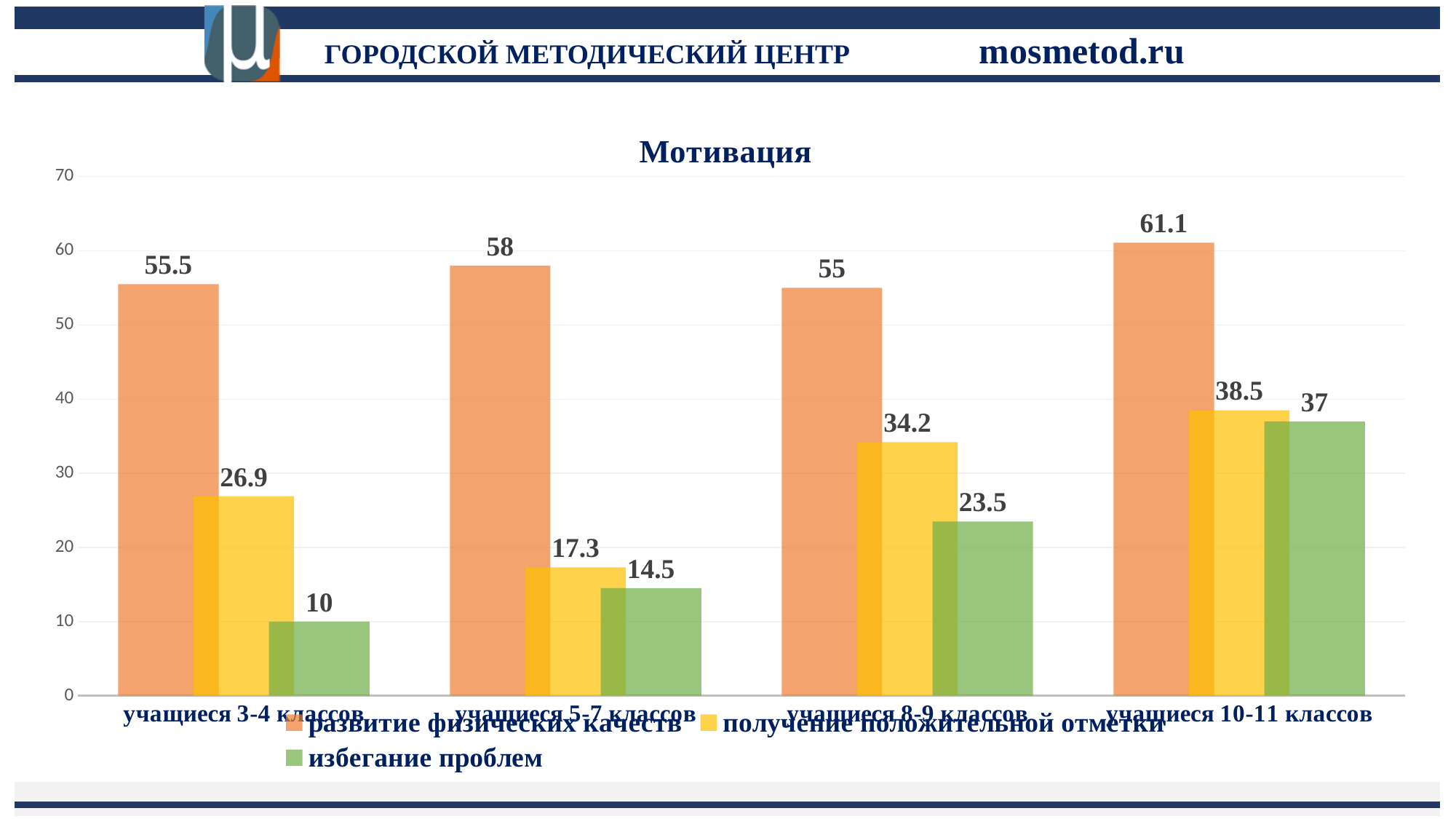
What is the value for «развитие физических качеств» among учащиеся 5-7 классов? 58 Does the value for «получение положительной отметки» rise or fall from учащиеся 5-7 классов to учащиеся 10-11 классов? rise What is the value for «получение положительной отметки» among учащиеся 8-9 классов? 34.2 How many series does the legend list? 3 What kind of chart is shown on the slide? bar chart Which is larger for учащиеся 8-9 классов: «получение положительной отметки» or «избегание проблем»? получение положительной отметки Is the value for «избегание проблем» among учащиеся 10-11 классов greater or less than 30? greater Which group has the highest value for «развитие физических качеств»? учащиеся 10-11 классов Which group has the lowest value for «избегание проблем»? учащиеся 3-4 классов What is the value for «избегание проблем» among учащиеся 3-4 классов? 10 How many student groups are shown on the x axis? 4 What is the difference between «получение положительной отметки» for учащиеся 10-11 классов and for учащиеся 3-4 классов? 11.6